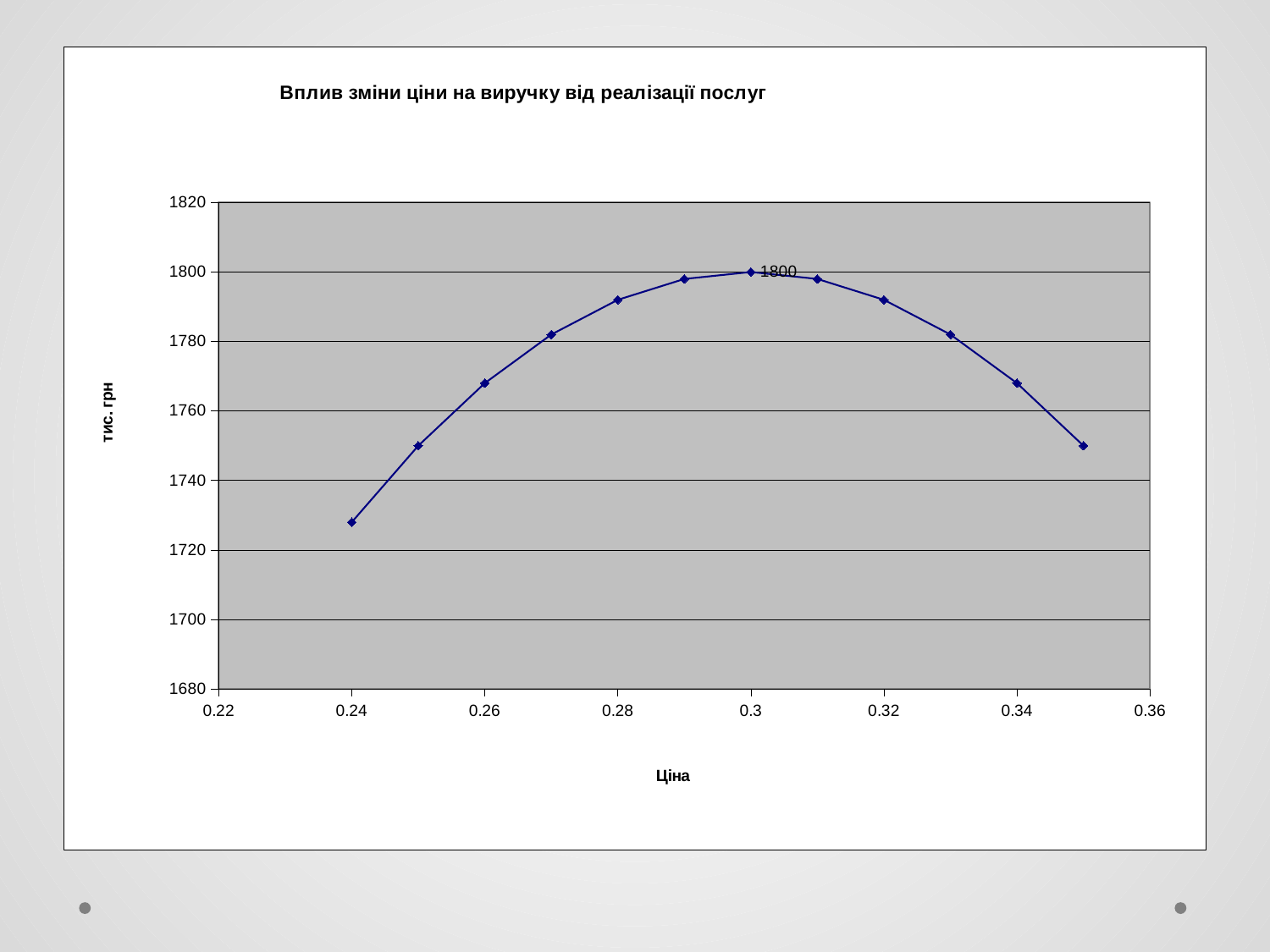
Which has the larger value: price 0.24 or price 0.35? 0.35 What is the value printed at the price 0.3? 1800 Is the value at price 0.34 greater or less than 1780? less What kind of chart is shown on the slide? line chart Is the value at price 0.35 greater or less than 1740? greater How many data points are plotted on the line? 12 At which price is the revenue highest? 0.3 At which price is the revenue lowest? 0.24 Is the value at price 0.28 greater or less than 1780? greater How do the values change as the price increases from 0.24 to 0.35? rise to a peak at 0.3, then fall What is the label of the vertical axis? тис. грн